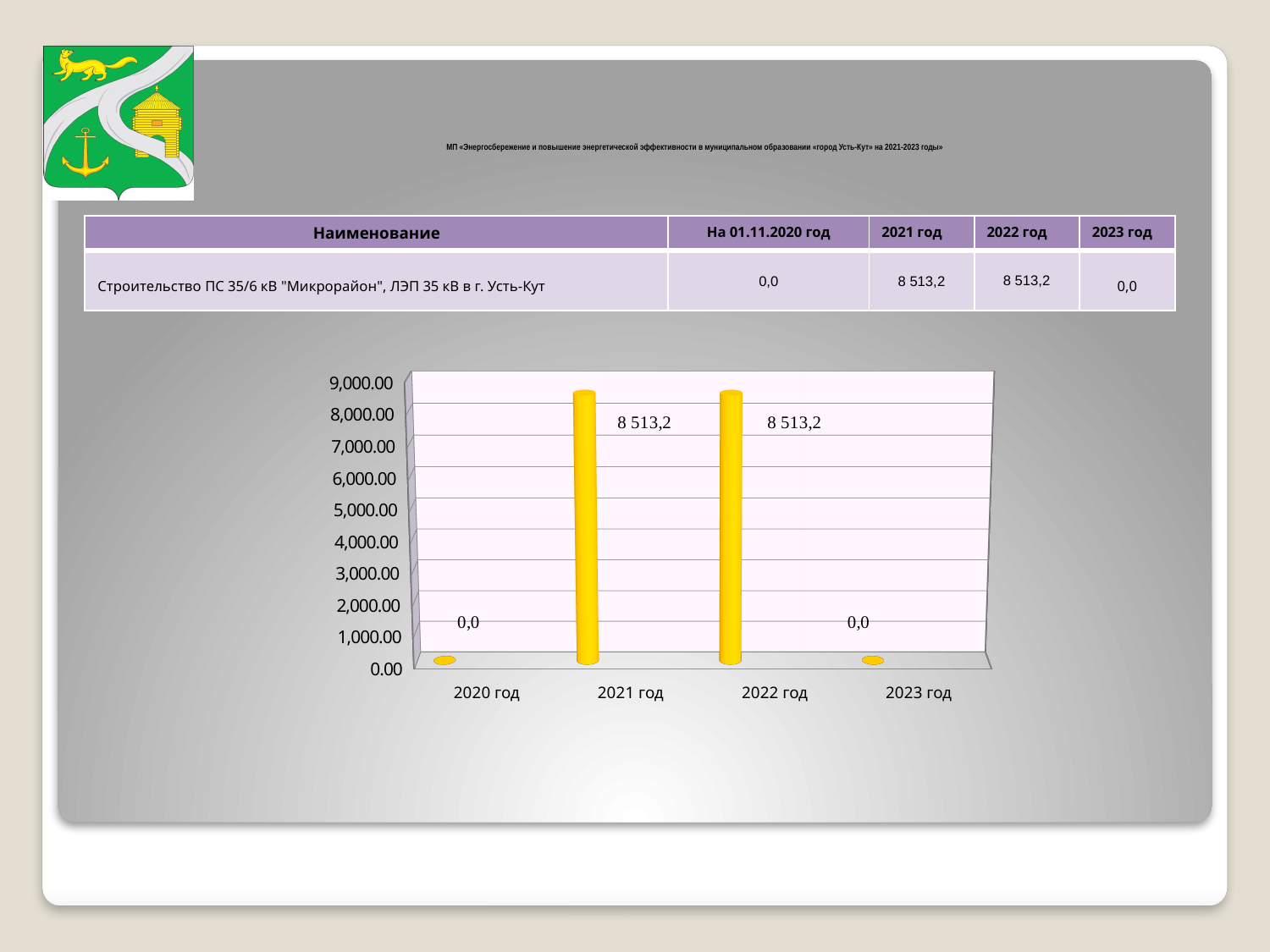
Is the value for 2021 год greater or less than 8,000.00? greater What kind of chart is shown on the slide? bar chart What is the value for 2023 год? 0,0 What is the value for 2021 год? 8 513,2 What is the difference between the values for 2022 год and 2023 год? 8 513,2 What is the value for 2022 год? 8 513,2 Does the value rise or fall from 2022 год to 2023 год? fall Which is larger, the value for 2020 год or the value for 2022 год? 2022 год Which is larger, the value for 2021 год or the value for 2023 год? 2021 год Is the value for 2023 год greater or less than 1,000.00? less How many categories are shown on the x axis of the chart? 4 What is the value for 2020 год? 0,0